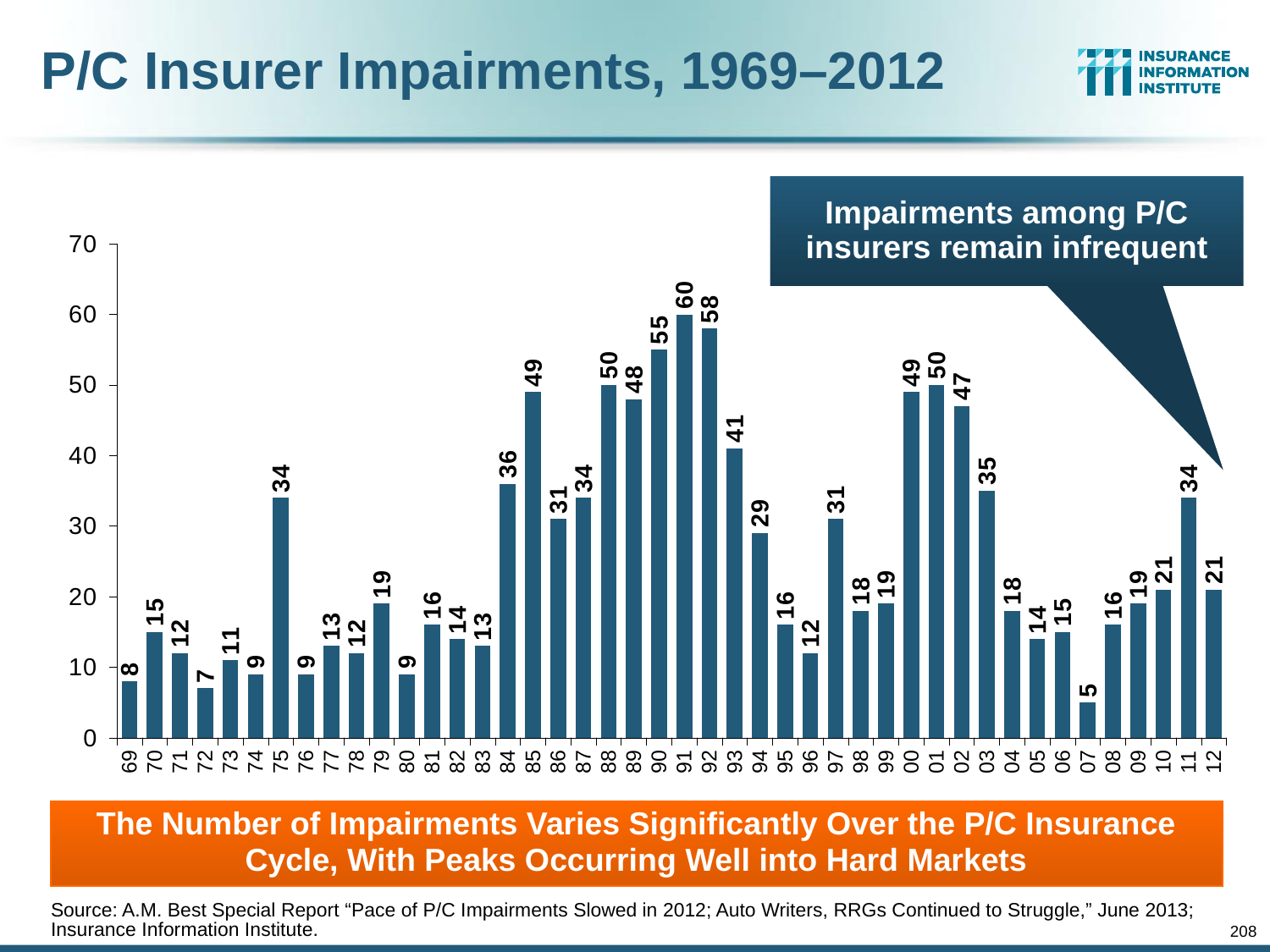
Is the value for 1990 greater or less than 50? greater What is the number of impairments shown for 2012 (label '12')? 21 What kind of chart is shown on the slide? Bar chart Which year has the highest number of impairments? 91 Which year has the lowest number of impairments? 07 How many years (bars) are plotted in the chart? 44 What is the difference between the impairments in 2011 (34) and 2012 (21)? 13 What is the number of P/C insurer impairments shown for 1991 (label '91')? 60 What is the number of impairments shown for 2007 (label '07')? 5 What is the difference between the impairments in 1991 (60) and 1992 (58)? 2 Which year had more impairments, 1985 or 2002? 1985 Do the impairment values rise or fall from 2007 to 2011? Rise